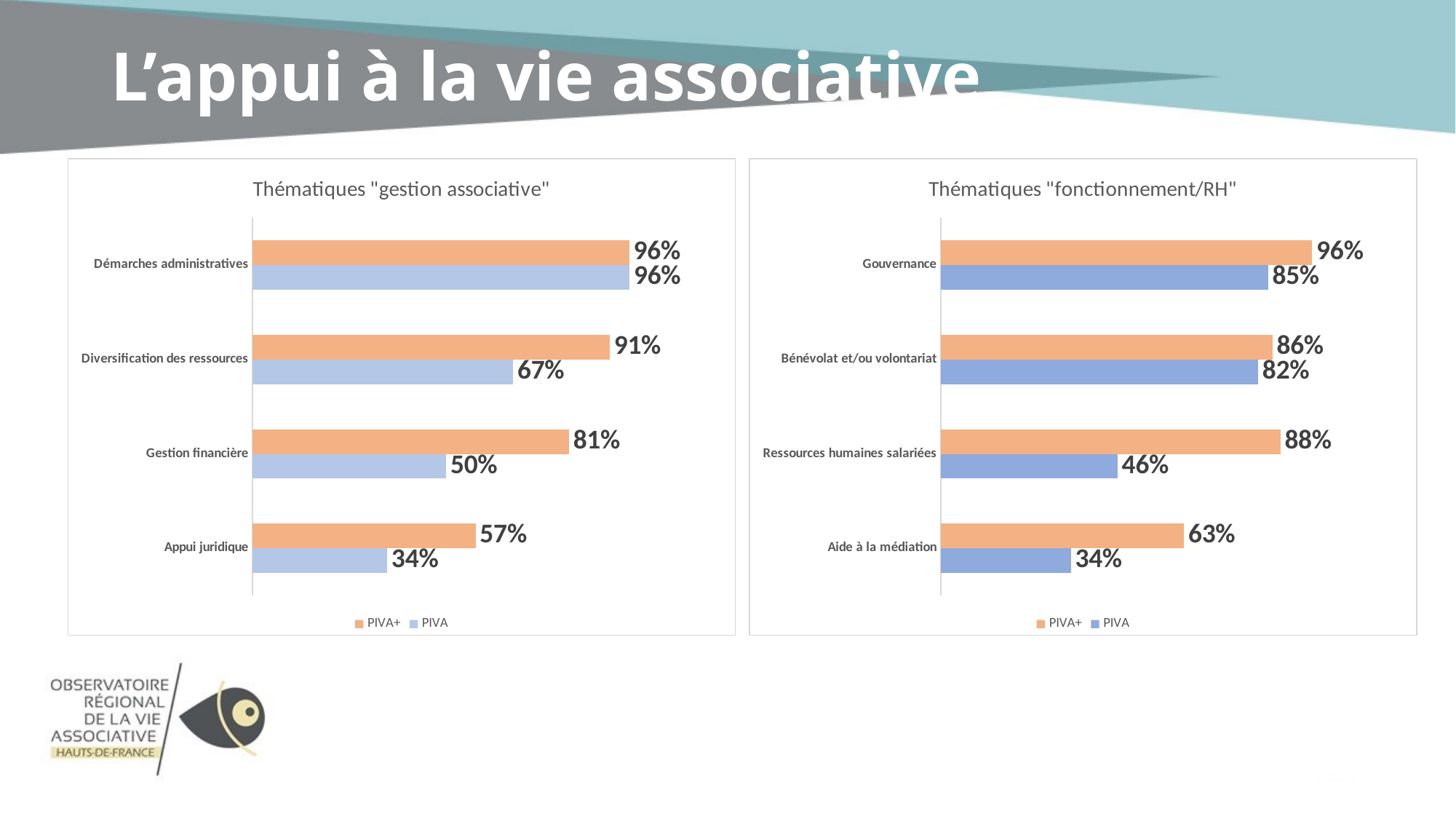
How many series does the legend list in the chart "Thématiques "fonctionnement/RH""? 2 In the chart "Thématiques "fonctionnement/RH"", what is the PIVA+ value for Aide à la médiation? 63% In the chart "Thématiques "fonctionnement/RH"", what is the PIVA value for Ressources humaines salariées? 46% In the chart "Thématiques "gestion associative"", what is the difference between the PIVA+ and PIVA values for Gestion financière? 31% In the chart "Thématiques "fonctionnement/RH"", which category has the highest PIVA+ value? Gouvernance How many categories are shown in the chart "Thématiques "gestion associative""? 4 In the chart "Thématiques "gestion associative"", what is the PIVA value for Gestion financière? 50% In the chart "Thématiques "gestion associative"", what is the PIVA+ value for Diversification des ressources? 91% In the chart "Thématiques "fonctionnement/RH"", what is the difference between the PIVA+ and PIVA values for Ressources humaines salariées? 42% In the chart "Thématiques "fonctionnement/RH"", which is larger for Bénévolat et/ou volontariat: the PIVA+ value or the PIVA value? PIVA+ What kind of chart is "Thématiques "gestion associative""? Bar chart In the chart "Thématiques "gestion associative"", which category has the lowest PIVA value? Appui juridique